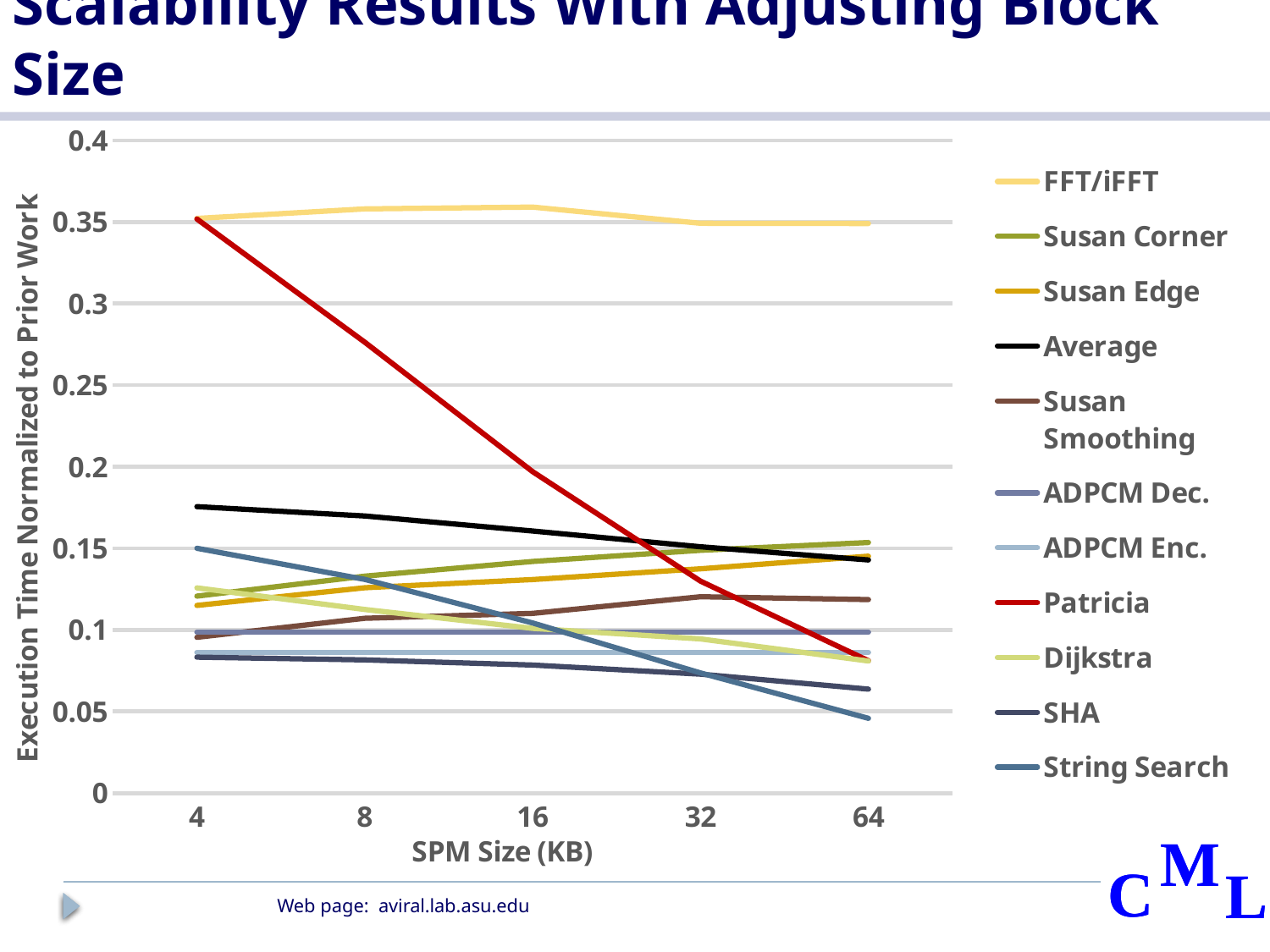
What kind of chart is shown on the slide? line chart What is the label of the x axis? SPM Size (KB) How many series does the legend list? 11 Which series has the highest value at an SPM size of 64 KB? FFT/iFFT Does the Patricia line rise or fall as SPM size increases from 4 to 64 KB? fall How many SPM size values are plotted along the x axis? 5 Is the value for Average at an SPM size of 4 KB greater or less than 0.15? greater Which series has the lowest value at an SPM size of 64 KB? String Search Is the value for Patricia at an SPM size of 4 KB greater or less than 0.3? greater Does the Susan Corner line rise or fall as SPM size increases from 4 to 64 KB? rise At an SPM size of 4 KB, which is larger: the value for Patricia or the value for Average? Patricia Is the value for Patricia at an SPM size of 64 KB greater or less than 0.1? less